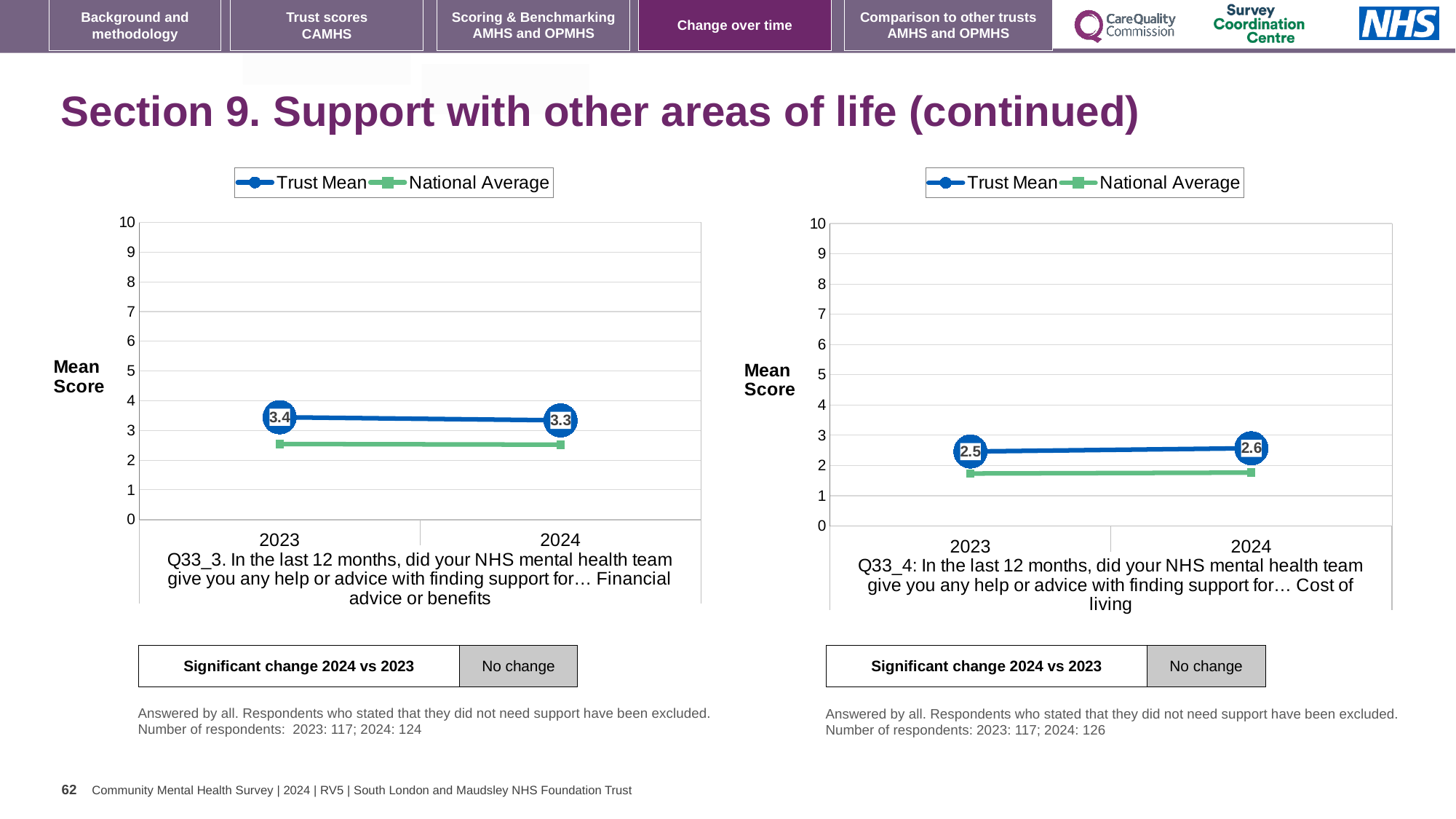
How many series does the legend of the right chart (Q33_4, Cost of living) list? 2 In the right chart (Q33_4, Cost of living), is the National Average for 2023 greater or less than 2? less In the left chart (Q33_3, Financial advice or benefits), what is the Trust Mean for 2023? 3.4 In the left chart (Q33_3, Financial advice or benefits), what is the difference between the Trust Mean in 2023 and in 2024? 0.1 In the left chart (Q33_3, Financial advice or benefits), what is the Trust Mean for 2024? 3.3 In the left chart (Q33_3, Financial advice or benefits), is the Trust Mean or the National Average higher in 2024? Trust Mean In the right chart (Q33_4, Cost of living), what is the Trust Mean for 2024? 2.6 In the right chart (Q33_4, Cost of living), does the Trust Mean rise or fall from 2023 to 2024? rise In the right chart (Q33_4, Cost of living), what is the Trust Mean for 2023? 2.5 What kind of chart is the left chart (Q33_3, Financial advice or benefits)? line chart In the left chart (Q33_3, Financial advice or benefits), does the Trust Mean rise or fall from 2023 to 2024? fall What is the label on the vertical axis of the right chart (Q33_4, Cost of living)? Mean Score